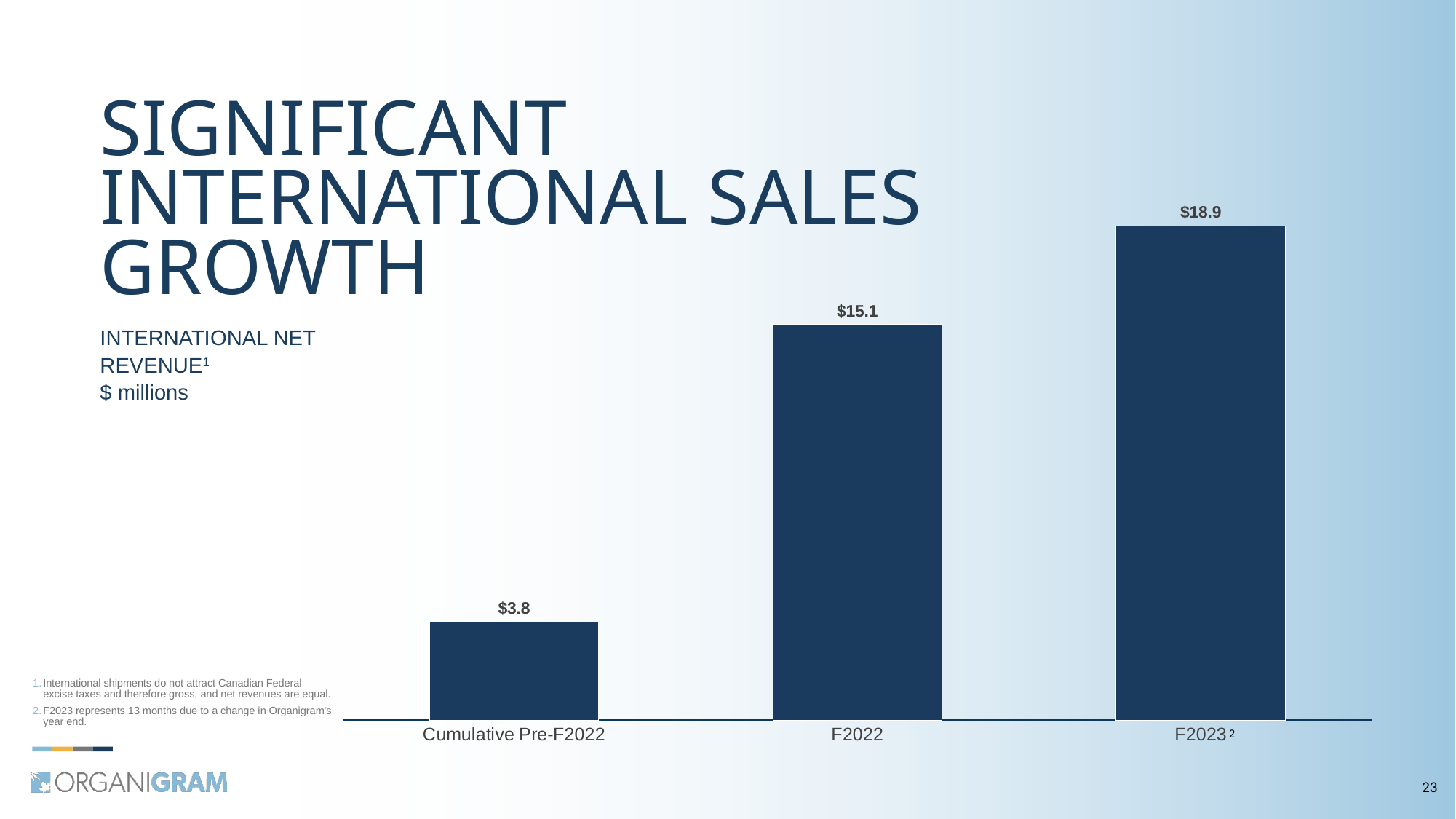
What is the difference between the F2022 and Cumulative Pre-F2022 international net revenue values? $11.3 What kind of chart is shown on the slide? Bar chart How many categories are shown in the chart? 3 Do the values rise or fall from left to right across the chart? Rise Which category has the lowest international net revenue? Cumulative Pre-F2022 What is the international net revenue for F2023? $18.9 What is the international net revenue for F2022? $15.1 Which category has the highest international net revenue? F2023 Which is larger, the international net revenue for F2022 or for Cumulative Pre-F2022? F2022 What is the difference between the F2023 and F2022 international net revenue values? $3.8 In what units are the chart values expressed? $ millions What is the international net revenue for Cumulative Pre-F2022? $3.8